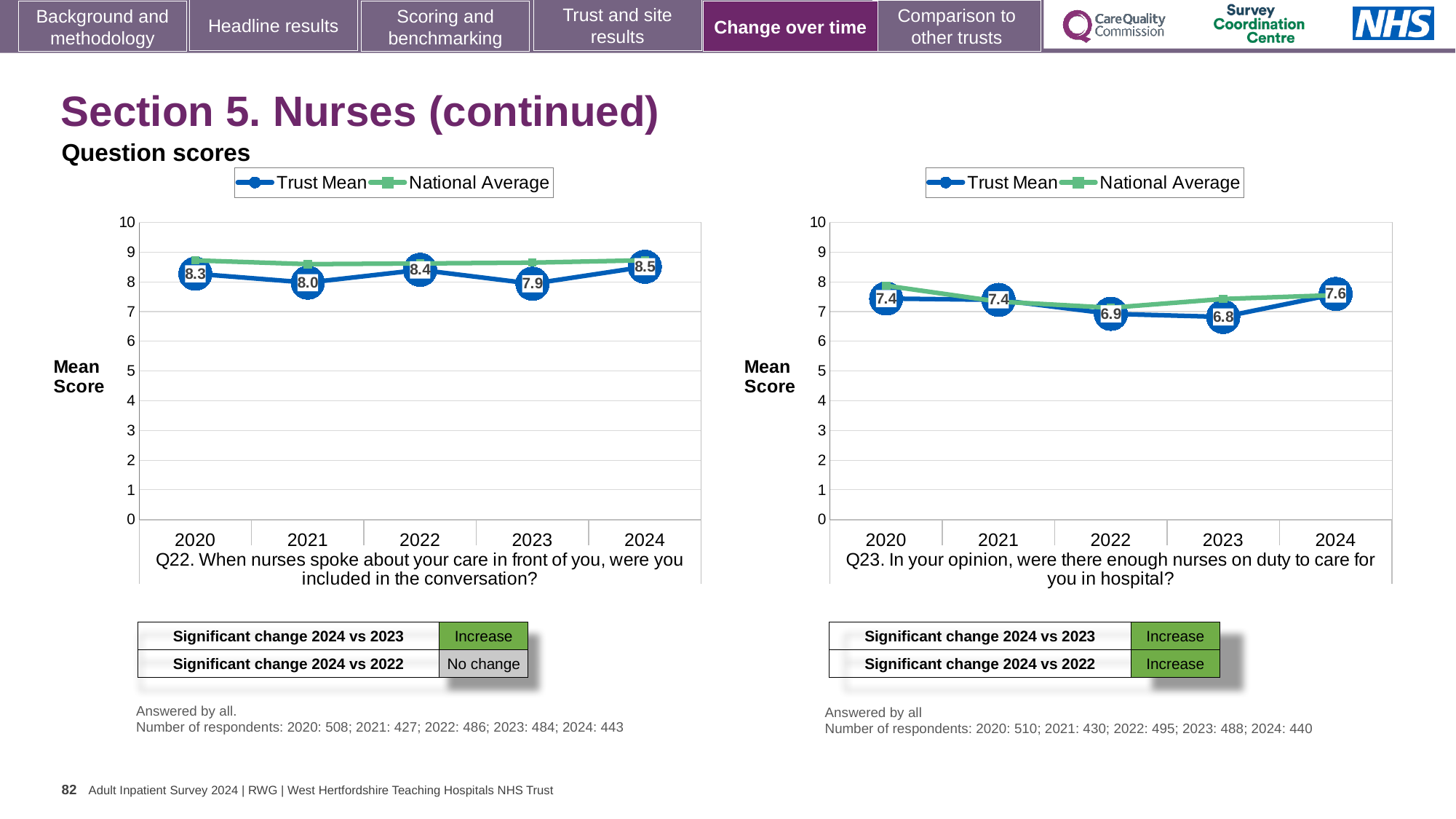
How many series does the legend of the Q22 chart (left) list? 2 In the Q23 chart (right), what is the Trust Mean score for 2022? 6.9 In the Q22 chart (left), what is the Trust Mean score for 2023? 7.9 In the Q22 chart (left), which year has the lowest Trust Mean score? 2023 In the Q23 chart (right), what is the difference between the Trust Mean scores for 2024 and 2023? 0.8 In the Q22 chart (left), what is the difference between the Trust Mean scores for 2024 and 2023? 0.6 In the Q23 chart (right), which year has the highest Trust Mean score? 2024 How many years are plotted on the x axis of the Q23 chart (right)? 5 In the Q22 chart (left), what is the Trust Mean score for 2024? 8.5 In the Q23 chart (right), is the Trust Mean score for 2022 larger or smaller than the score for 2024? smaller In the Q23 chart (right), which year has the lowest Trust Mean score? 2023 In the Q22 chart (left), is the National Average for 2020 greater or less than 8? greater